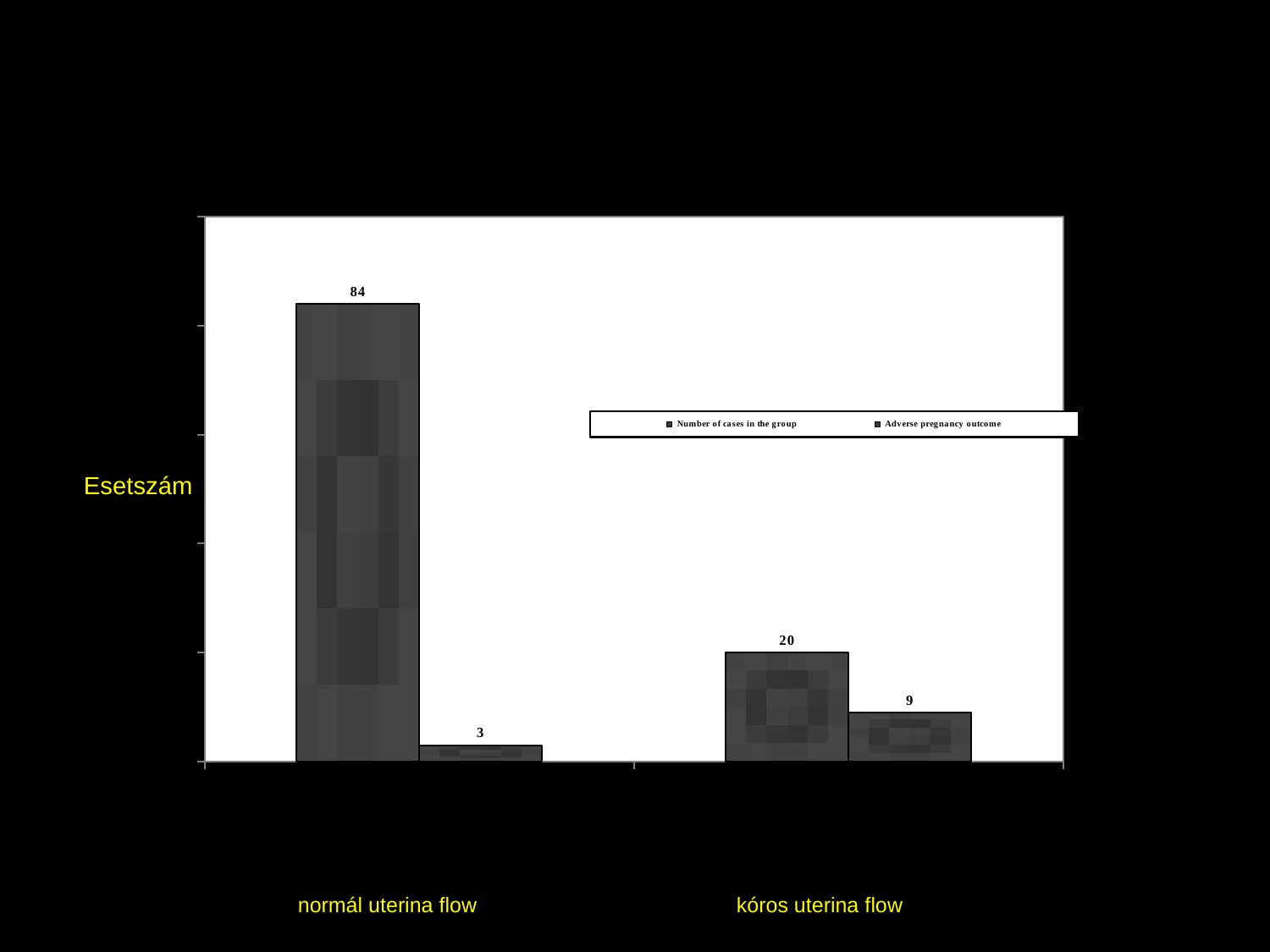
Which category has the lowest value for "Adverse pregnancy outcome"? normál uterina flow Which category has the highest value for "Number of cases in the group"? normál uterina flow What kind of chart is shown on the slide? bar chart How many series does the legend list? 2 What is the value for "Adverse pregnancy outcome" in the "normál uterina flow" category? 3 What is the difference between the "Number of cases in the group" values for "normál uterina flow" and "kóros uterina flow"? 64 How many categories are shown on the x axis of the chart? 2 Which is larger: "Adverse pregnancy outcome" for "kóros uterina flow" or for "normál uterina flow"? kóros uterina flow What is the value for "Number of cases in the group" in the "kóros uterina flow" category? 20 What is the difference between "Number of cases in the group" and "Adverse pregnancy outcome" in the "kóros uterina flow" category? 11 What is the value for "Adverse pregnancy outcome" in the "kóros uterina flow" category? 9 What is the value for "Number of cases in the group" in the "normál uterina flow" category? 84